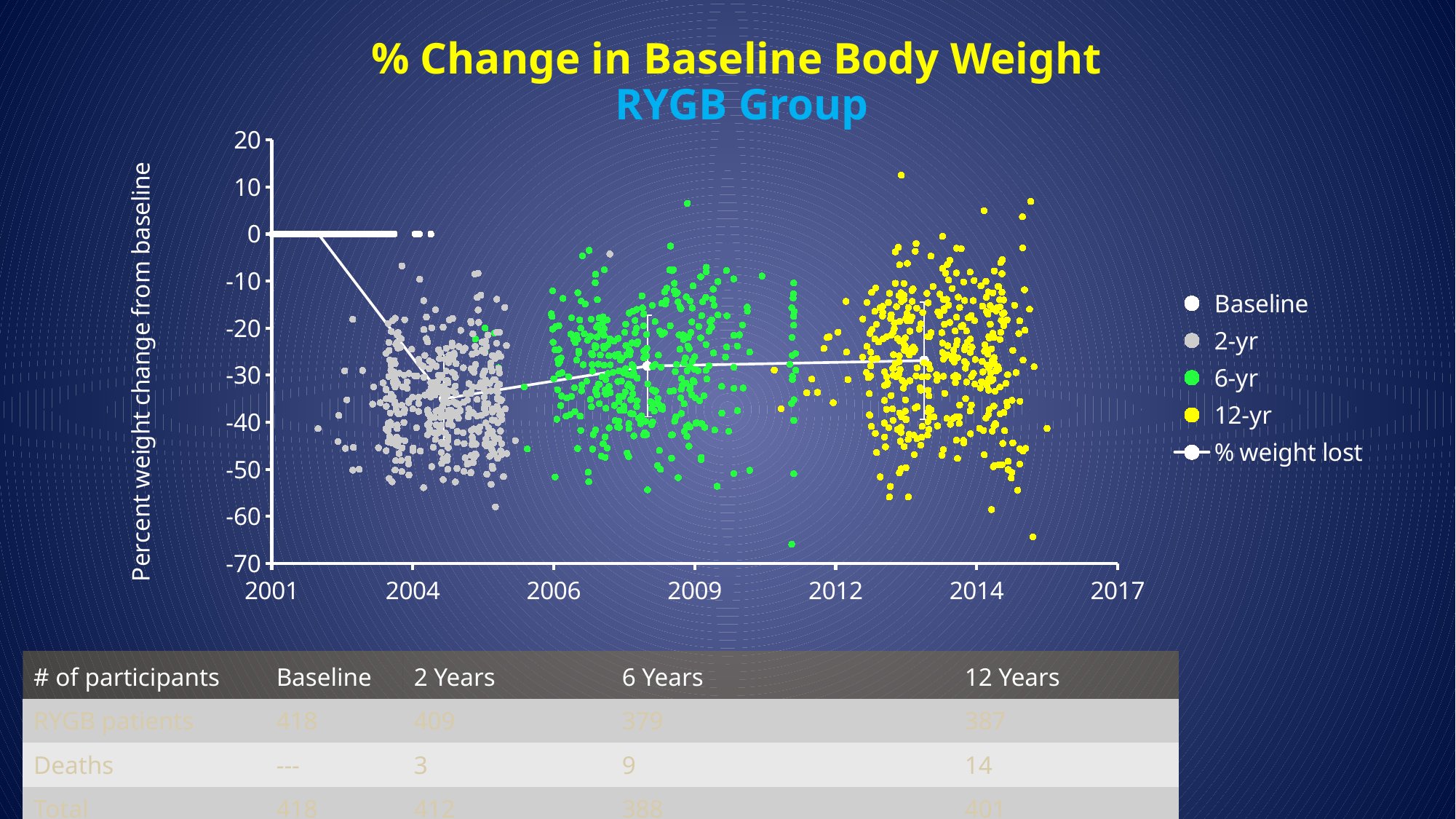
What is the lowest value shown on the y axis of the chart? -70 What is the value of the % weight lost line at Baseline? 0 Does the % weight lost line rise or fall from Baseline to 2-yr? fall Is the value of the % weight lost line at 2-yr greater or less than -30? less What colour are the 12-yr points in the chart? yellow What kind of chart is shown on the slide? scatter chart Which has the lower value on the % weight lost line, 2-yr or 12-yr? 2-yr How many entries does the chart legend list? 5 Is the value of the % weight lost line at 12-yr greater or less than -20? less How many year labels are shown on the x axis of the chart? 7 Is the value of the % weight lost line at 6-yr greater or less than -20? less What is the title of the chart? % Change in Baseline Body Weight RYGB Group